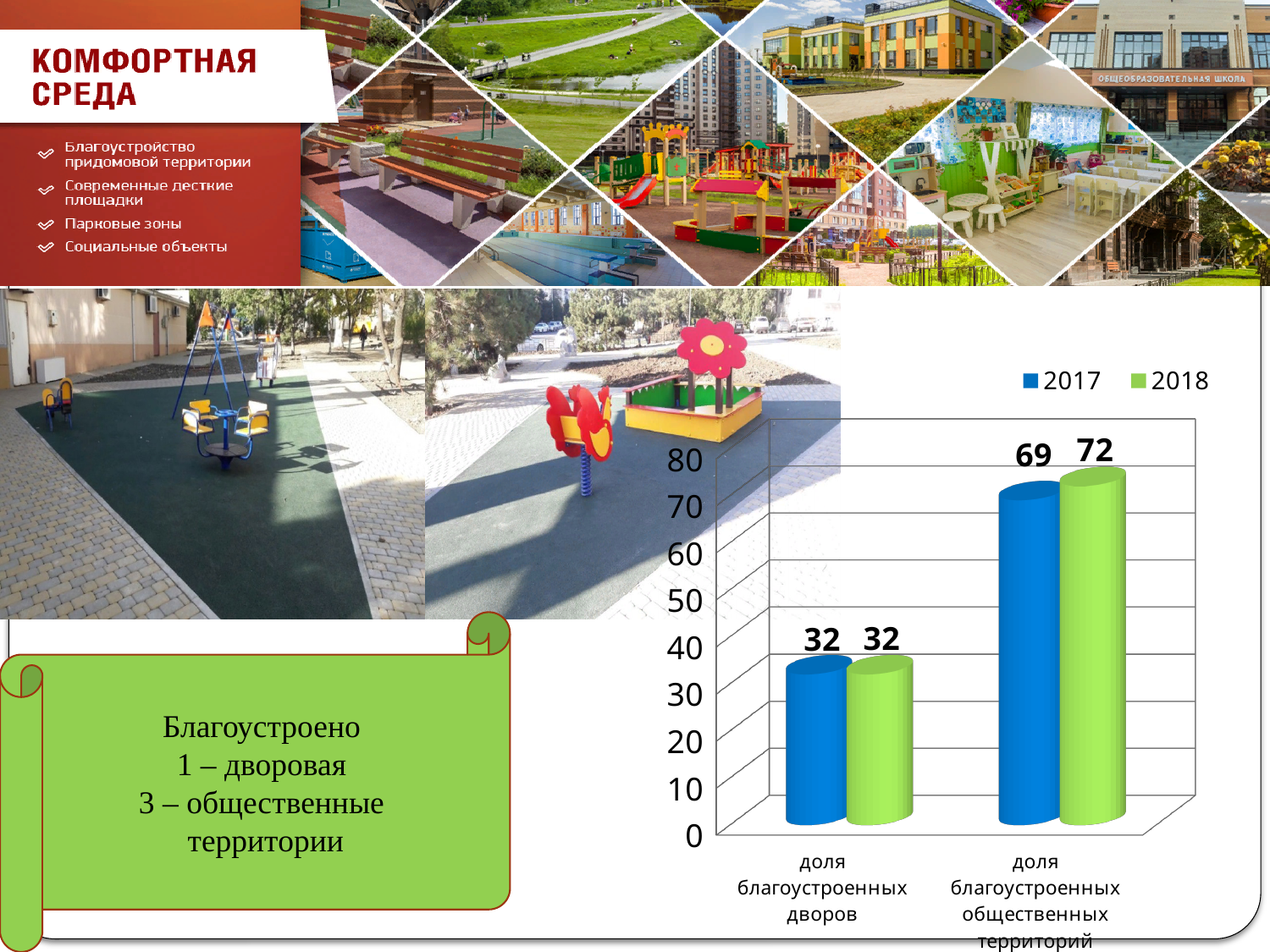
Which category has the highest value in the 2018 series? доля благоустроенных общественных территорий What is the value for 2018 for "доля благоустроенных дворов"? 32 What kind of chart is shown on the slide? bar chart What is the value for 2017 for "доля благоустроенных общественных территорий"? 69 What is the difference between the 2017 values for "доля благоустроенных общественных территорий" and "доля благоустроенных дворов"? 37 What is the value for 2017 for "доля благоустроенных дворов"? 32 How many series does the chart legend list? 2 What is the difference between the 2018 and 2017 values for "доля благоустроенных общественных территорий"? 3 Which category has the lowest value in the 2017 series? доля благоустроенных дворов Which is larger: the 2017 value for "доля благоустроенных дворов" or the 2017 value for "доля благоустроенных общественных территорий"? доля благоустроенных общественных территорий How many categories are shown on the x axis of the chart? 2 What is the value for 2018 for "доля благоустроенных общественных территорий"? 72